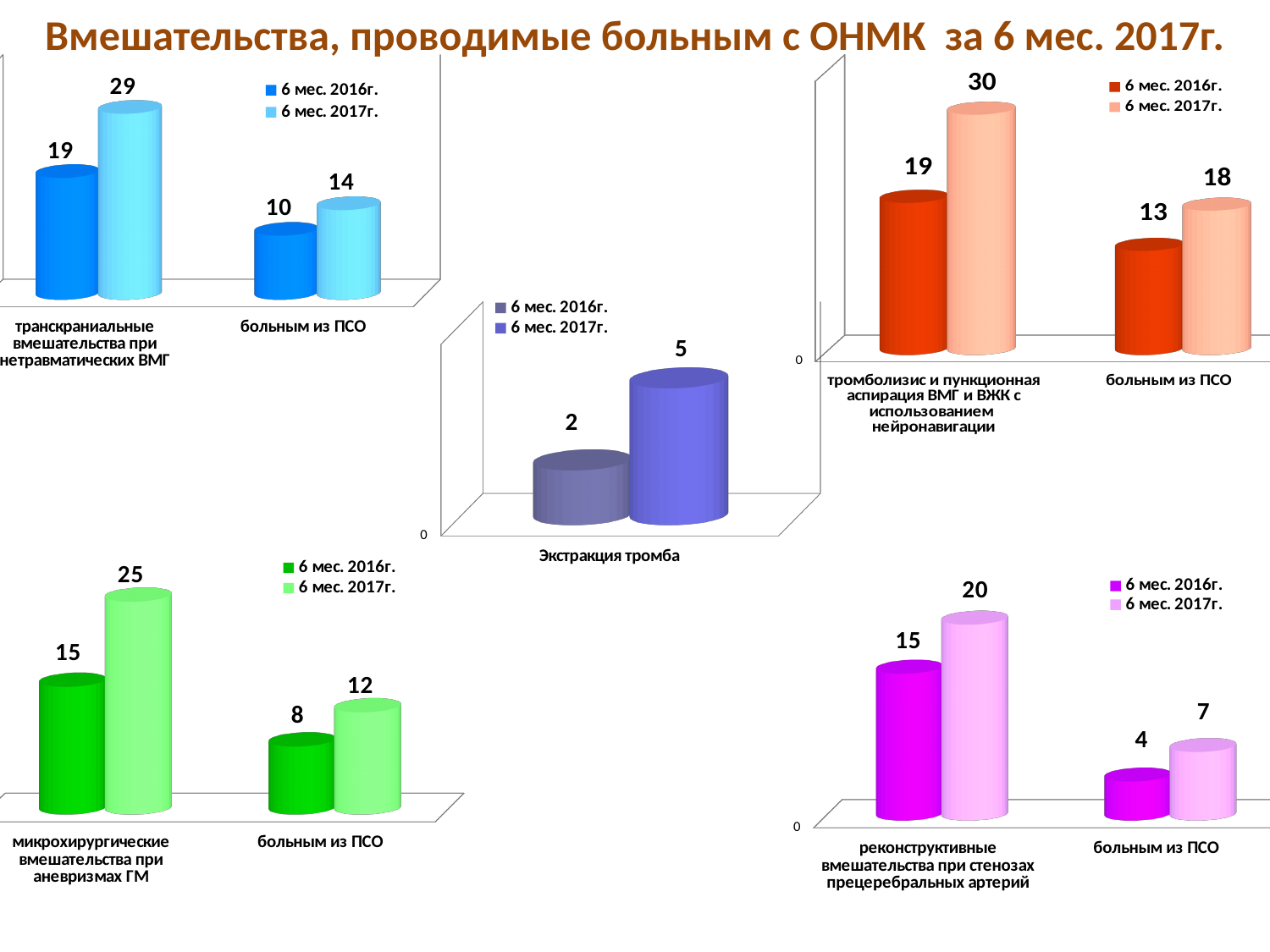
In the bottom-right chart, what is the difference between the 6 мес. 2017г. and 6 мес. 2016г. values for реконструктивные вмешательства при стенозах прецеребральных артерий? 5 In the top-left chart, what is the difference between the 6 мес. 2017г. and 6 мес. 2016г. values for больным из ПСО? 4 In the top-right chart, what is the value for 6 мес. 2017г. for тромболизис и пункционная аспирация ВМГ и ВЖК с использованием нейронавигации? 30 In the bottom-right chart, what is the value for 6 мес. 2016г. for больным из ПСО? 4 In the center chart (Экстракция тромба), what is the difference between the 6 мес. 2017г. and 6 мес. 2016г. values? 3 In the bottom-left chart, what is the value for 6 мес. 2016г. for микрохирургические вмешательства при аневризмах ГМ? 15 How many series does the legend of the bottom-right chart list? 2 What type of chart is the top-left chart? Bar chart In the bottom-left chart, which bar is the highest? 6 мес. 2017г. for микрохирургические вмешательства при аневризмах ГМ (25) In the top-right chart, which is larger for больным из ПСО: 6 мес. 2016г. or 6 мес. 2017г.? 6 мес. 2017г. In the top-left chart, what is the value for 6 мес. 2017г. for транскраниальные вмешательства при нетравматических ВМГ? 29 In the center chart (Экстракция тромба), what is the value for 6 мес. 2016г.? 2